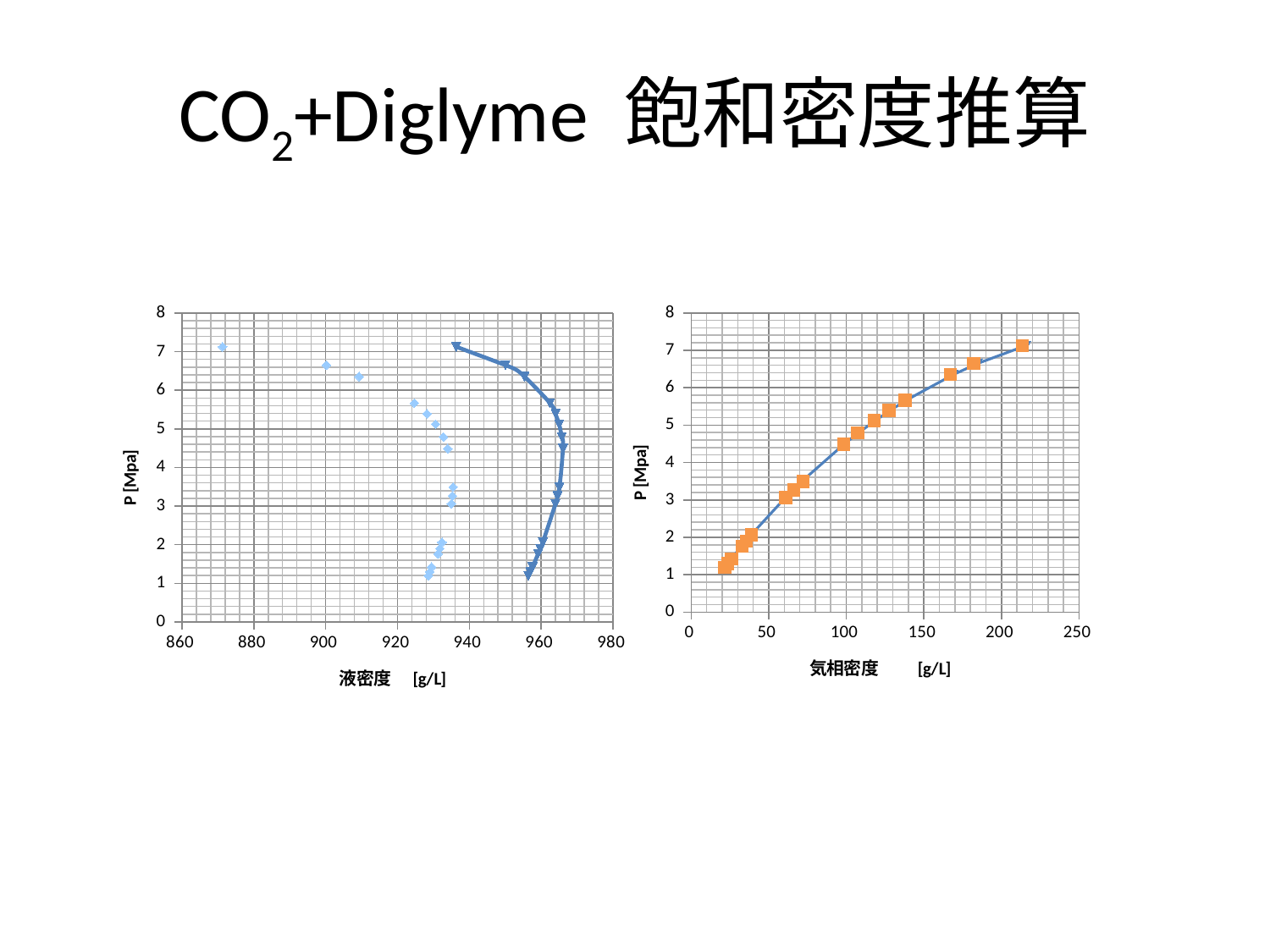
In the right-hand chart (気相密度), is the gas-phase density of the highest-pressure point greater or less than 200 g/L? greater In the right-hand chart (気相密度), is the gas-phase density of the lowest-pressure point greater or less than 50 g/L? less In the left-hand chart (液密度), what is the maximum value shown on the x axis? 980 How many charts are on the slide? 2 In the right-hand chart (気相密度), does pressure rise or fall as gas-phase density increases along the x axis? rise What kind of chart is the left-hand chart (液密度)? scatter chart In the left-hand chart (液密度), is the liquid density of the light blue point at about 7 MPa greater or less than 880 g/L? less In the right-hand chart (気相密度), what is the maximum value shown on the y axis? 8 In the right-hand chart (気相密度), what is the label of the x axis? 気相密度 [g/L] What kind of chart is the right-hand chart (気相密度)? scatter chart